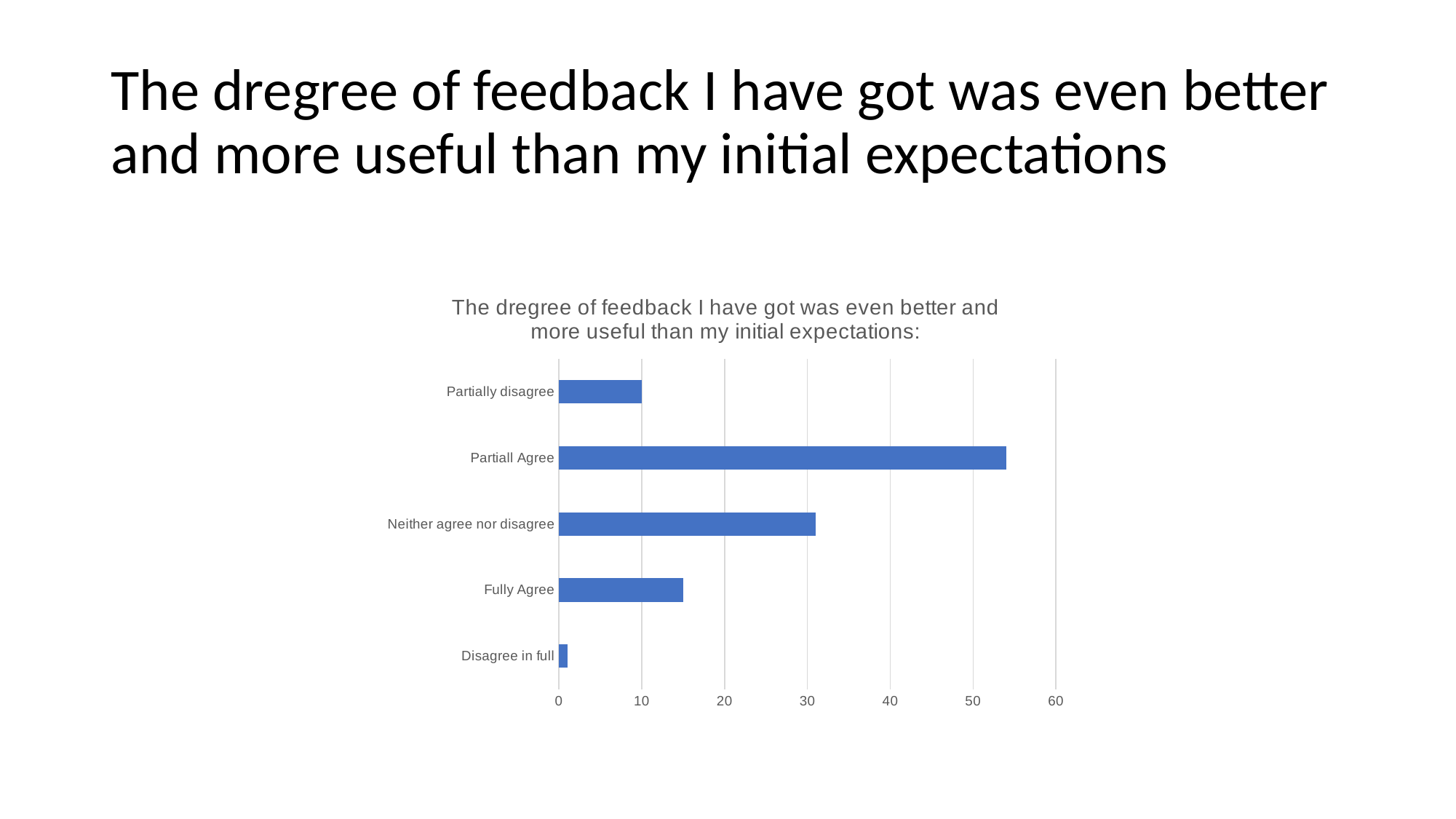
How many categories are shown in the chart? 5 Is the value for Partiall Agree greater or less than 50? greater What colour are the bars in the chart? blue Which is larger, the value for Neither agree nor disagree or the value for Partiall Agree? Partiall Agree Which is larger, the value for Fully Agree or the value for Partially disagree? Fully Agree Is the value for Fully Agree greater or less than 20? less Which category has the lowest value? Disagree in full Which category has the highest value? Partiall Agree Is the value for Disagree in full greater or less than 10? less What is the highest value shown on the horizontal axis? 60 What kind of chart is shown on the slide? bar chart